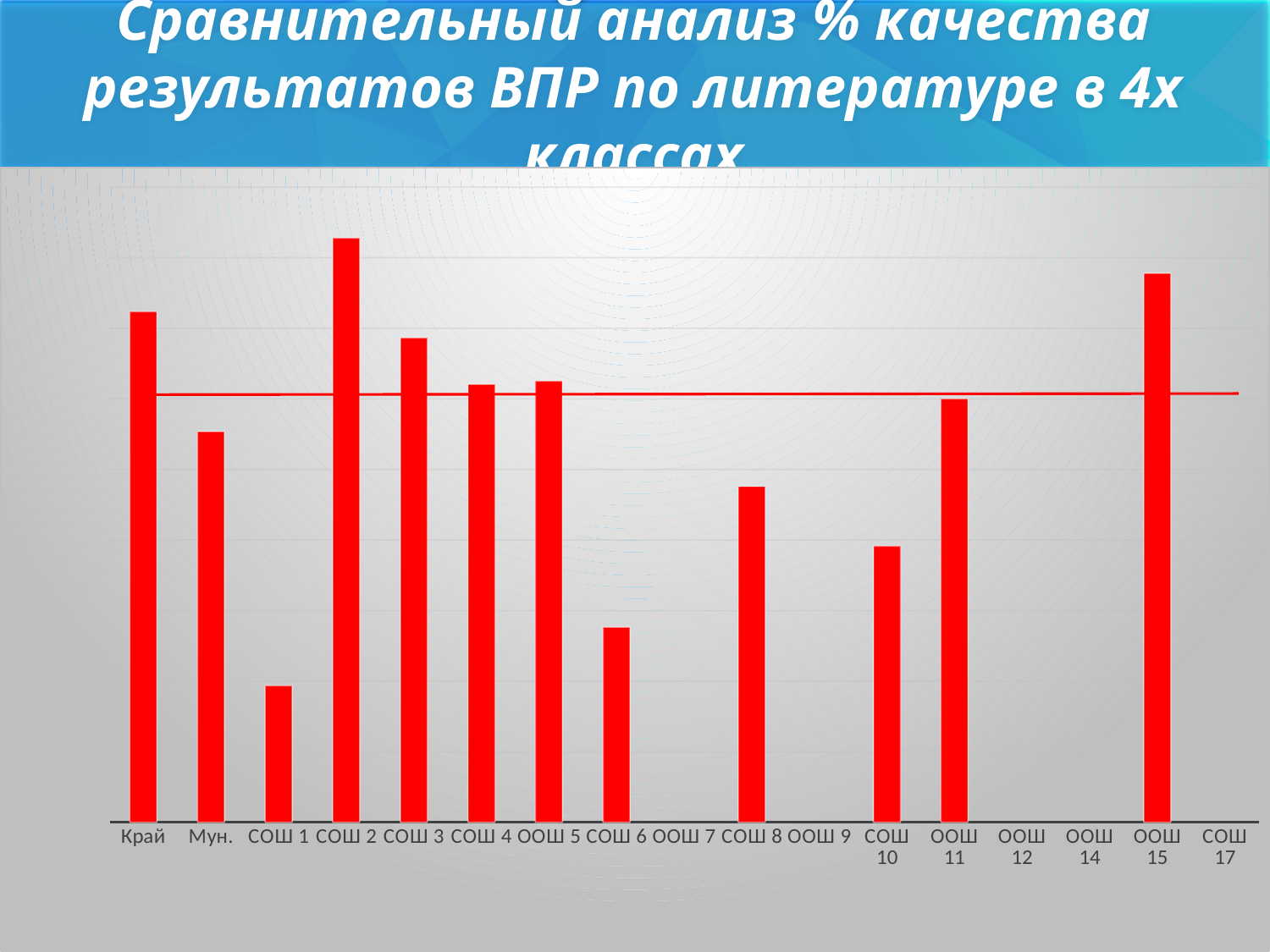
How many categories are labelled on the x axis? 17 How many categories have a visible bar? 12 What colour are the bars in the chart? red Which is larger, the value for Край or the value for Мун.? Край Which is larger, the value for ООШ 15 or the value for Край? ООШ 15 Which category's bar is the second highest? ООШ 15 Which is larger, the value for СОШ 6 or the value for СОШ 10? СОШ 10 Which category has the highest bar? СОШ 2 What kind of chart is shown on the slide? bar chart Among the categories with a visible bar, which has the lowest value? СОШ 1